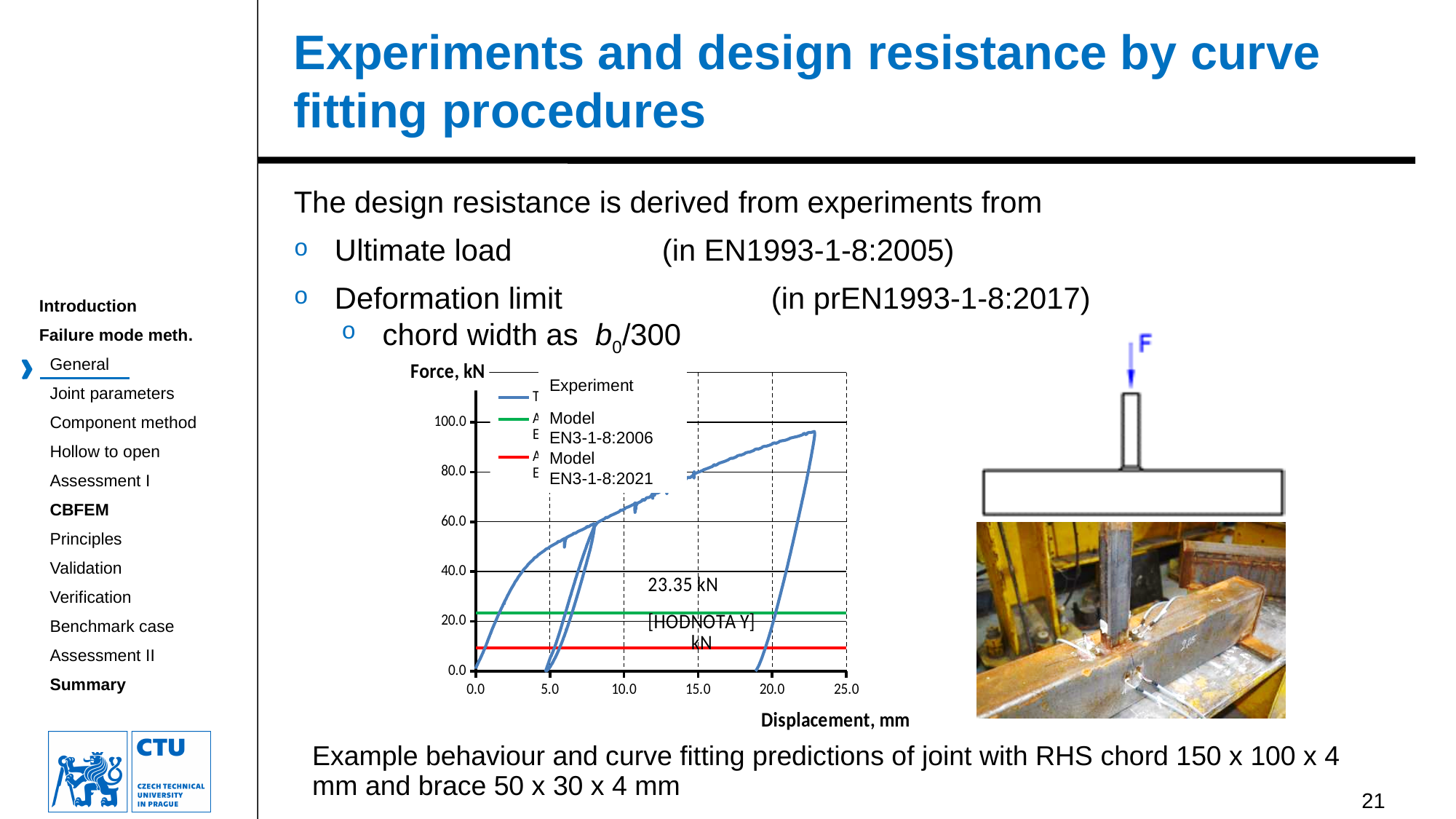
Is the peak force of the Experiment curve greater or less than 100.0 kN? less Is the force level of the Model EN3-1-8:2021 line greater or less than 20.0 kN? less Is the displacement at which the Experiment curve reaches its peak force greater or less than 20.0 mm? greater How many series does the chart legend list? 3 Which series reaches the highest force on the chart? Experiment Which model line lies at a higher force, Model EN3-1-8:2006 or Model EN3-1-8:2021? Model EN3-1-8:2006 What kind of chart is shown on the slide? line chart What is the label of the horizontal axis of the chart? Displacement, mm What force value is labelled on the Model EN3-1-8:2006 line? 23.35 kN What is the label of the vertical axis of the chart? Force, kN